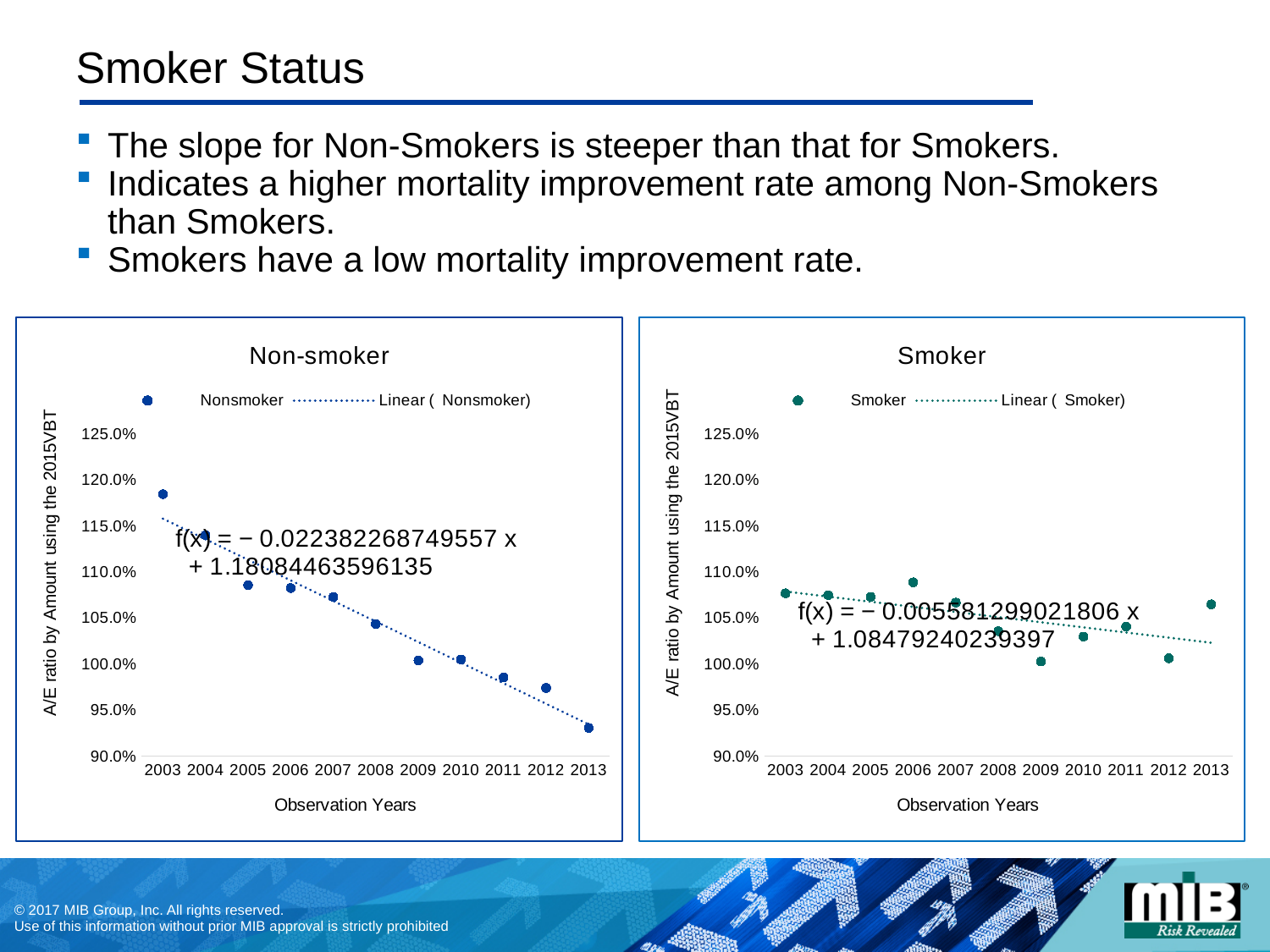
In the Non-smoker chart, which observation year has the highest A/E ratio? 2003 In the Smoker chart, which observation year has the highest A/E ratio? 2006 In the Non-smoker chart, is the value for 2013 greater or less than 95.0%? less In the Smoker chart, which is larger, the value for 2006 or the value for 2009? 2006 In the Non-smoker chart, do the A/E ratios rise or fall from 2003 to 2013? fall How many entries does the legend of the Smoker chart list? 2 What kind of chart is the Non-smoker chart? scatter chart What is the x-axis title of the Non-smoker chart? Observation Years How many observation years are plotted in the Smoker chart? 11 In the Smoker chart, is the value for 2009 greater or less than 105.0%? less In the Non-smoker chart, which observation year has the lowest A/E ratio? 2013 In the Non-smoker chart, is the value for 2003 greater or less than 115.0%? greater